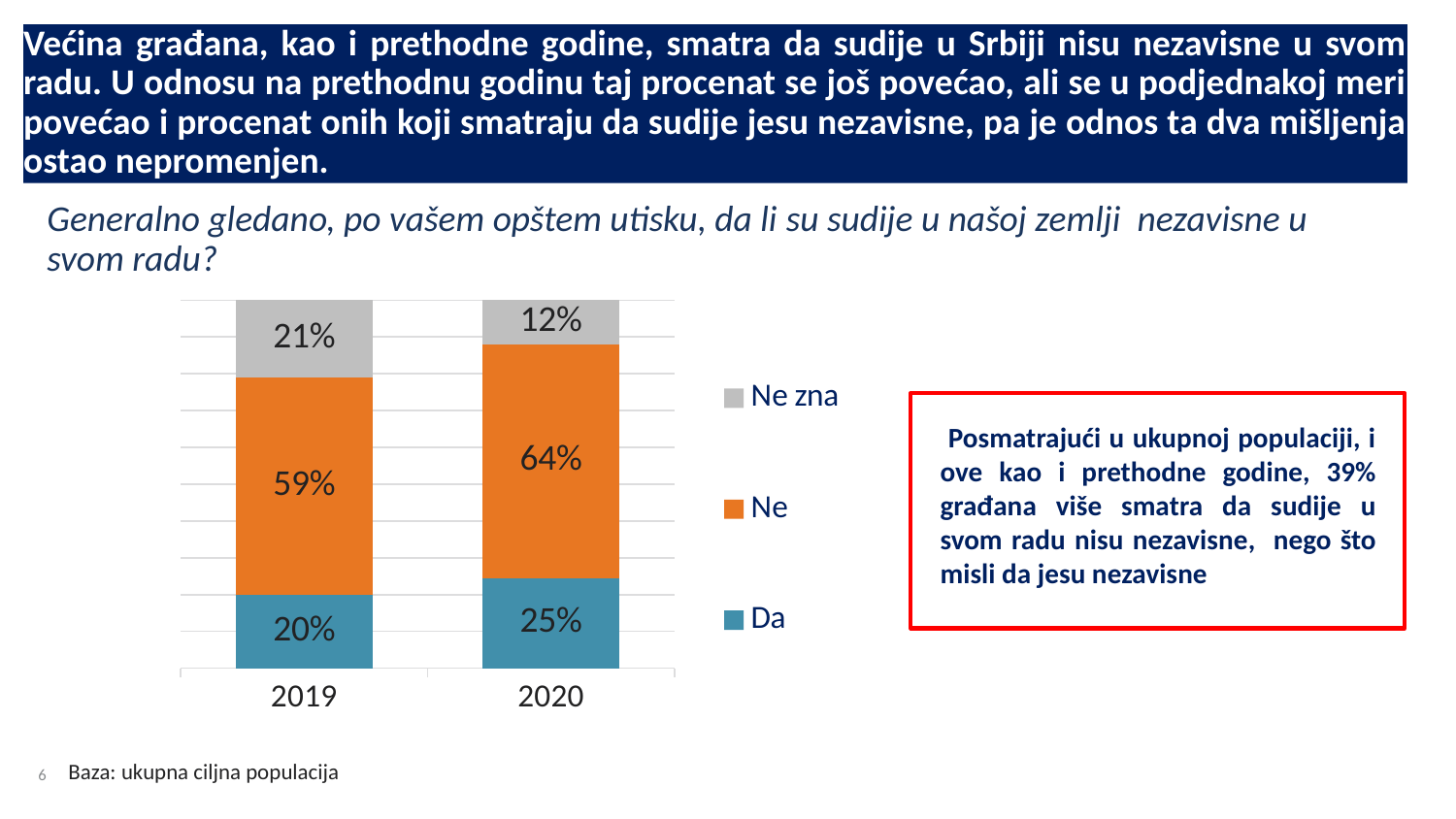
What kind of chart is shown? Stacked bar chart What percentage answered "Ne" in 2019? 59% Which colour represents "Ne" in the chart? Orange How many series does the legend list? 3 By how many percentage points did the "Ne zna" share fall from 2019 to 2020? 9 What percentage answered "Ne" in 2020? 64% Did the "Ne" share rise or fall from 2019 to 2020? Rise What percentage answered "Ne zna" in 2020? 12% How many years are shown on the x axis? 2 Which year has the higher "Da" share, 2019 or 2020? 2020 What is the difference between the "Ne" and "Da" shares in 2020? 39 What percentage answered "Da" in 2019? 20%